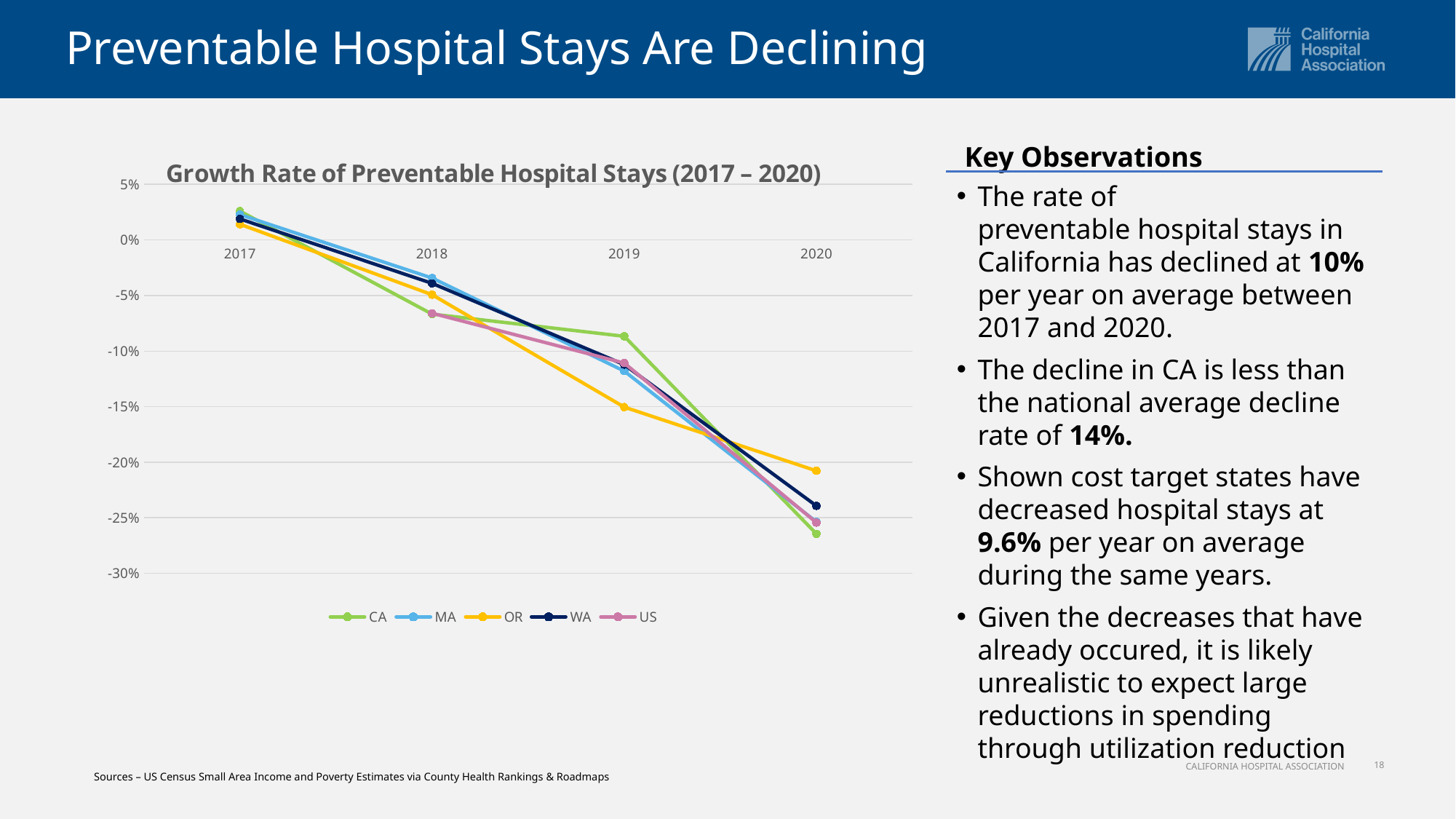
Which series has the highest value in 2019? CA Does the CA line rise or fall from 2017 to 2020? fall How many series does the legend of the chart list? 5 Is the value for WA in 2020 greater or less than -20%? less What is the title of the chart? Growth Rate of Preventable Hospital Stays (2017 – 2020) What kind of chart is shown on the slide? line chart Which series has the highest value in 2020? OR Is the value for OR in 2019 greater or less than -10%? less How many years are plotted along the x axis of the chart? 4 In 2020, which is larger, the value for OR or the value for WA? OR Which series in the legend is drawn in yellow? OR Which series has the lowest value in 2019? OR